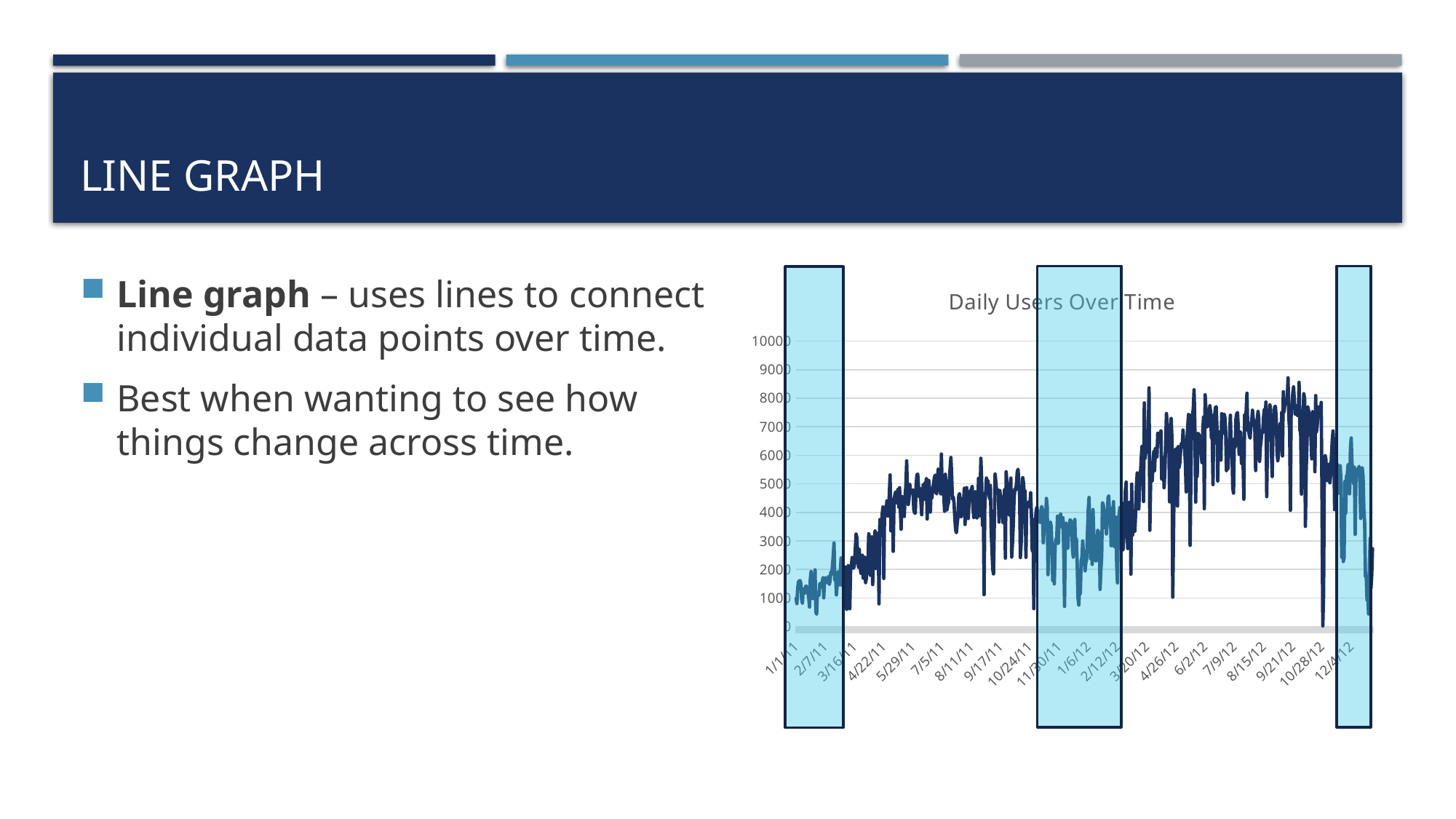
What is the highest tick value shown on the y axis? 10000 Is the value for 5/29/11 greater or less than 3000? greater Do the values rise or fall between 11/30/11 and 1/6/12 compared with the preceding months? fall Is the value for 1/6/12 greater or less than 6000? less How many light-blue highlighted rectangles are drawn over the chart? 3 What is the title of the chart? Daily Users Over Time Is the value for 7/9/12 greater or less than 4000? greater What kind of chart is shown on the slide? Line chart Which is larger, the value around 8/15/12 or the value around 2/7/11? 8/15/12 Overall, do daily users rise or fall from 1/1/11 to 9/21/12? rise In which year do the highest daily user values occur, 2011 or 2012? 2012